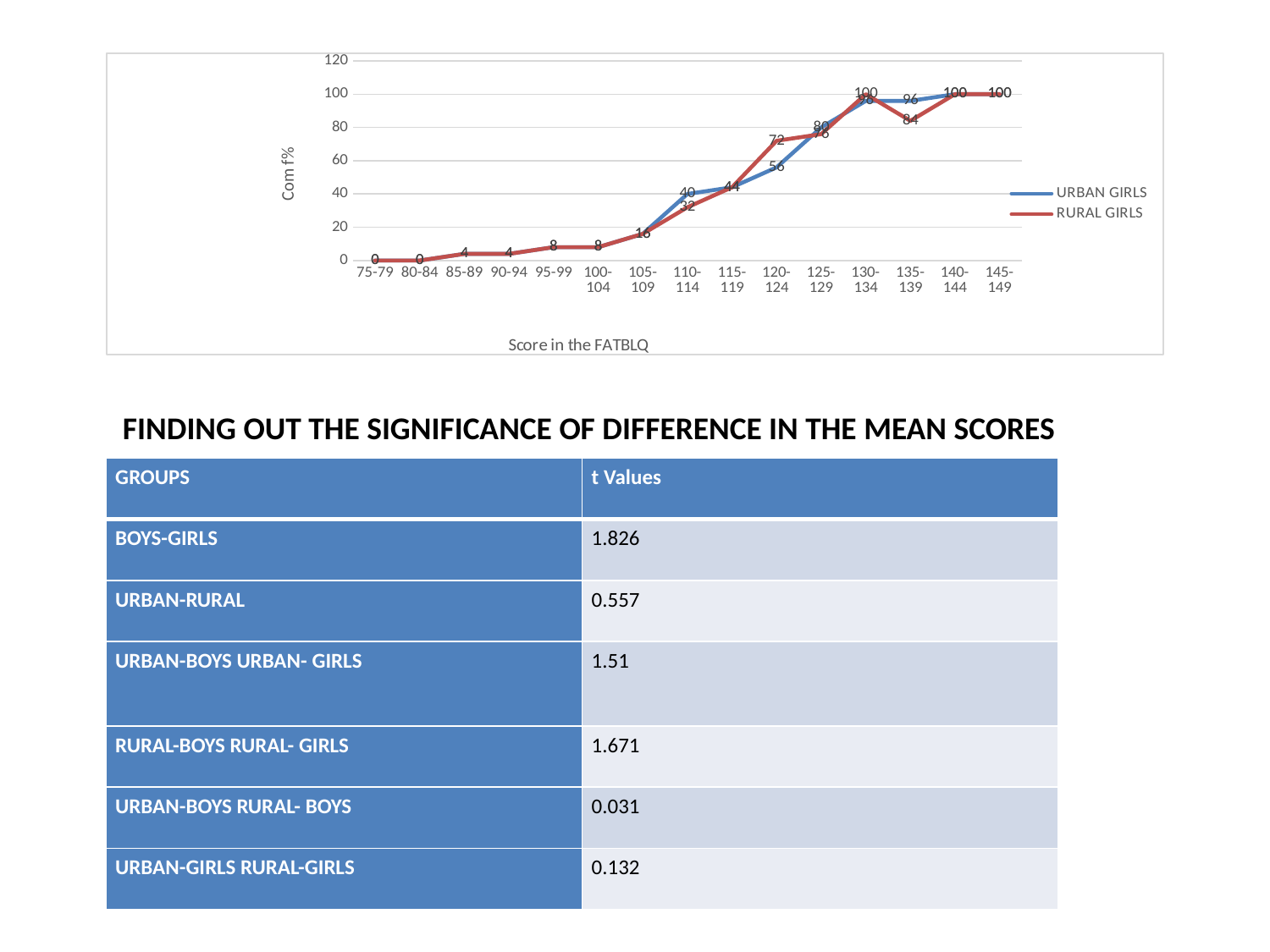
How many series does the chart legend list? 2 What is the value for RURAL GIRLS in the 135-139 score range? 84 What is the difference between URBAN GIRLS and RURAL GIRLS in the 135-139 score range? 12 What is the difference between RURAL GIRLS and URBAN GIRLS in the 120-124 score range? 16 Do the values for URBAN GIRLS generally rise or fall as the score ranges increase along the x axis? rise What is the value for RURAL GIRLS in the 110-114 score range? 32 What is the title of the x axis of the chart? Score in the FATBLQ What kind of chart is shown on the slide? line chart In the 120-124 score range, which series has the higher value, URBAN GIRLS or RURAL GIRLS? RURAL GIRLS What is the value for URBAN GIRLS in the 120-124 score range? 56 What is the value for URBAN GIRLS in the 135-139 score range? 96 How many score ranges are shown along the x axis of the chart? 15